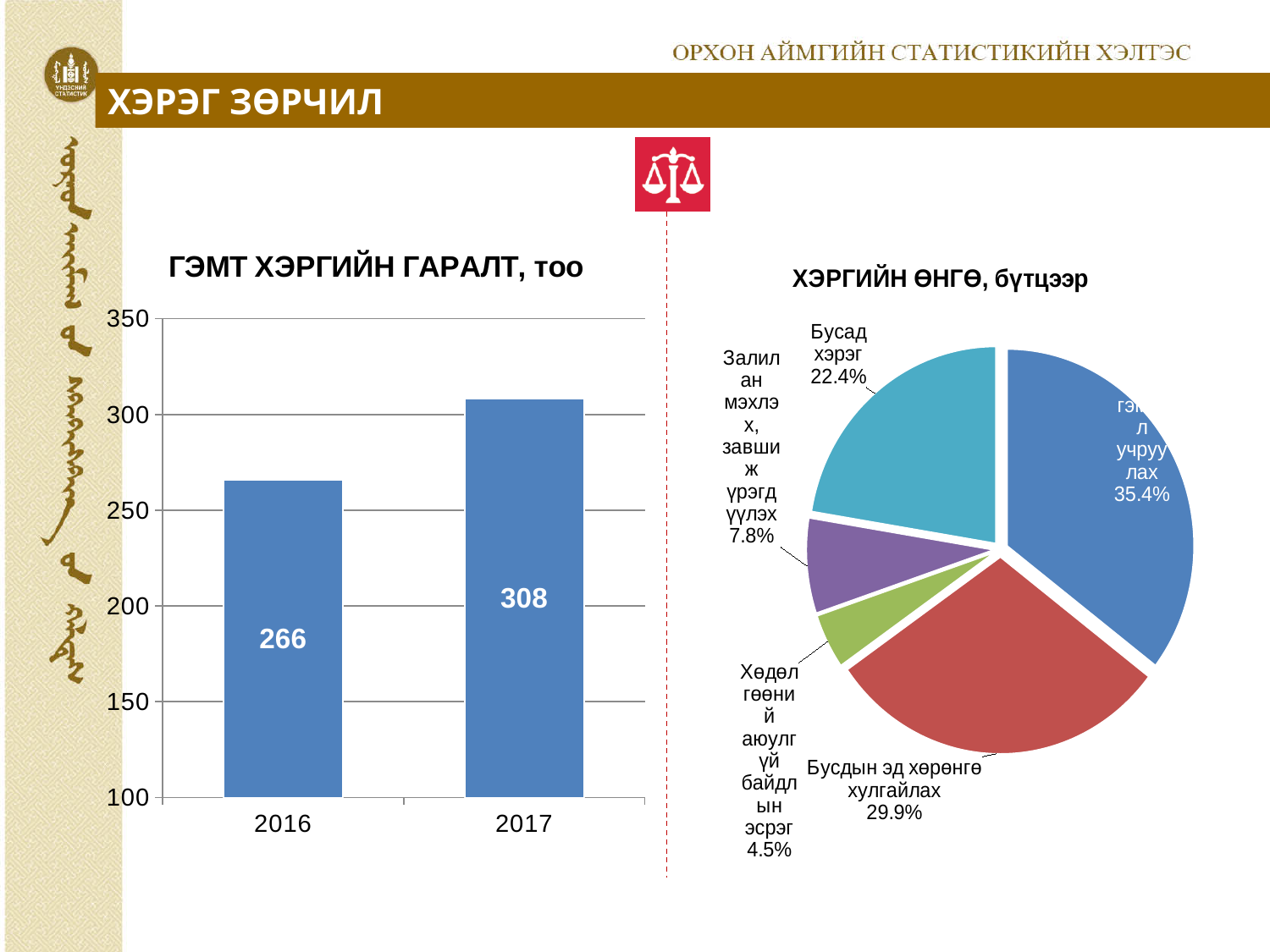
In the bar chart 'ГЭМТ ХЭРГИЙН ГАРАЛТ, тоо', do the values rise or fall from 2016 to 2017? rise In the pie chart 'ХЭРГИЙН ӨНГӨ, бүтцээр', what share is 'Бусад хэрэг'? 22.4% In the pie chart 'ХЭРГИЙН ӨНГӨ, бүтцээр', how many slices are there? 5 In the pie chart 'ХЭРГИЙН ӨНГӨ, бүтцээр', which is larger: 'Залилан мэхлэх, завшиж үрэгдүүлэх' or 'Хөдөлгөөний аюулгүй байдлын эсрэг'? Залилан мэхлэх, завшиж үрэгдүүлэх In the bar chart 'ГЭМТ ХЭРГИЙН ГАРАЛТ, тоо', how many years are shown? 2 In the bar chart 'ГЭМТ ХЭРГИЙН ГАРАЛТ, тоо', by how much does the 2017 value exceed the 2016 value? 42 In the pie chart 'ХЭРГИЙН ӨНГӨ, бүтцээр', what share is 'Хөдөлгөөний аюулгүй байдлын эсрэг'? 4.5% What kind of chart is 'ГЭМТ ХЭРГИЙН ГАРАЛТ, тоо'? bar chart In the bar chart 'ГЭМТ ХЭРГИЙН ГАРАЛТ, тоо', which year has the higher value? 2017 In the pie chart 'ХЭРГИЙН ӨНГӨ, бүтцээр', what share is 'Бусдын эд хөрөнгө хулгайлах'? 29.9% In the bar chart 'ГЭМТ ХЭРГИЙН ГАРАЛТ, тоо', what is the value for 2017? 308 In the bar chart 'ГЭМТ ХЭРГИЙН ГАРАЛТ, тоо', what is the value for 2016? 266